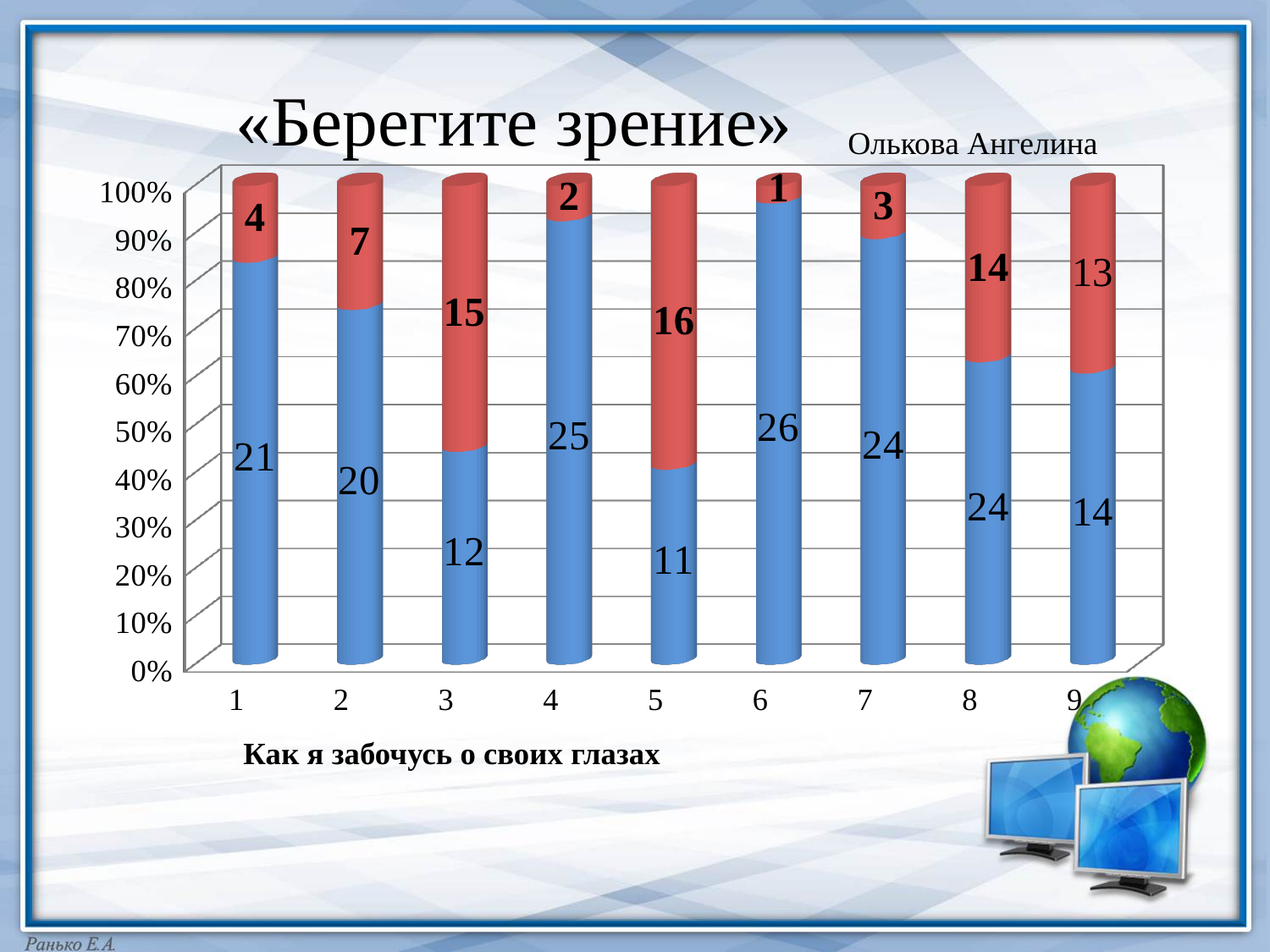
What is the difference between the blue segment values for categories 4 and 3? 13 How many categories are shown on the x axis? 9 What is the value of the blue segment for category 6? 26 Which category has the smallest red segment value? 6 What is the value of the blue segment for category 3? 12 Which category has the largest red segment value? 5 What is the value of the red segment for category 5? 16 Is the blue portion of the bar for category 3 greater or less than 50%? less Which is larger: the red segment value for category 8 or for category 9? category 8 Which category has the largest blue segment value? 6 What is the total of the blue and red values for category 1? 25 What kind of chart is shown on the slide? bar chart